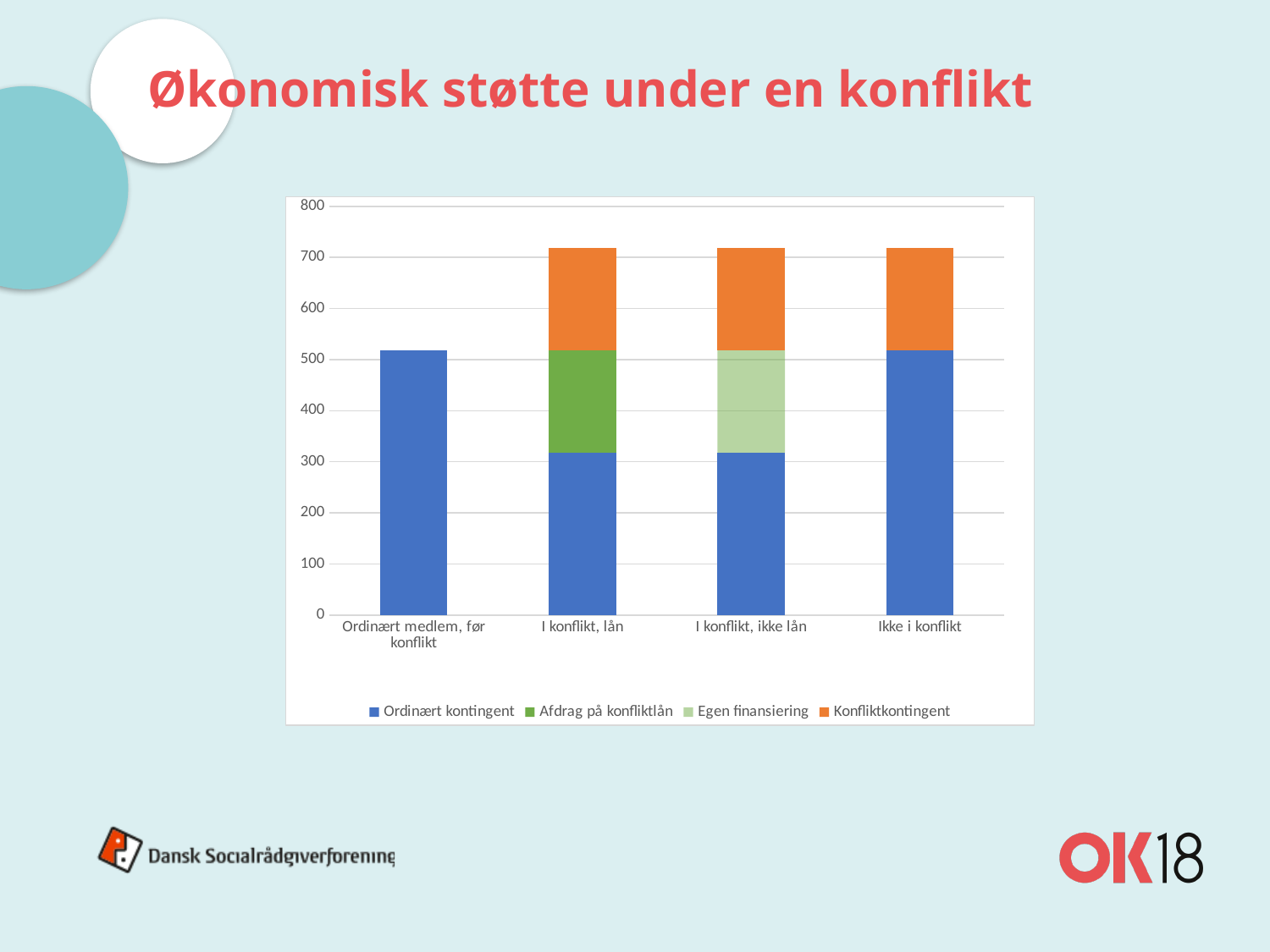
Is the total bar for 'Ordinært medlem, før konflikt' greater or less than 400? greater Is the total bar for 'I konflikt, lån' greater or less than 600? greater What kind of chart is shown on the slide? Stacked bar chart Is the total bar for 'Ordinært medlem, før konflikt' greater or less than 600? less Which has the larger total bar: 'Ordinært medlem, før konflikt' or 'I konflikt, ikke lån'? I konflikt, ikke lån How many series does the chart legend list? 4 What is the title of the slide containing the chart? Økonomisk støtte under en konflikt How many categories are shown on the x axis of the chart? 4 Which category has the lowest total bar height? Ordinært medlem, før konflikt Which series appears only in the 'I konflikt, ikke lån' bar? Egen finansiering